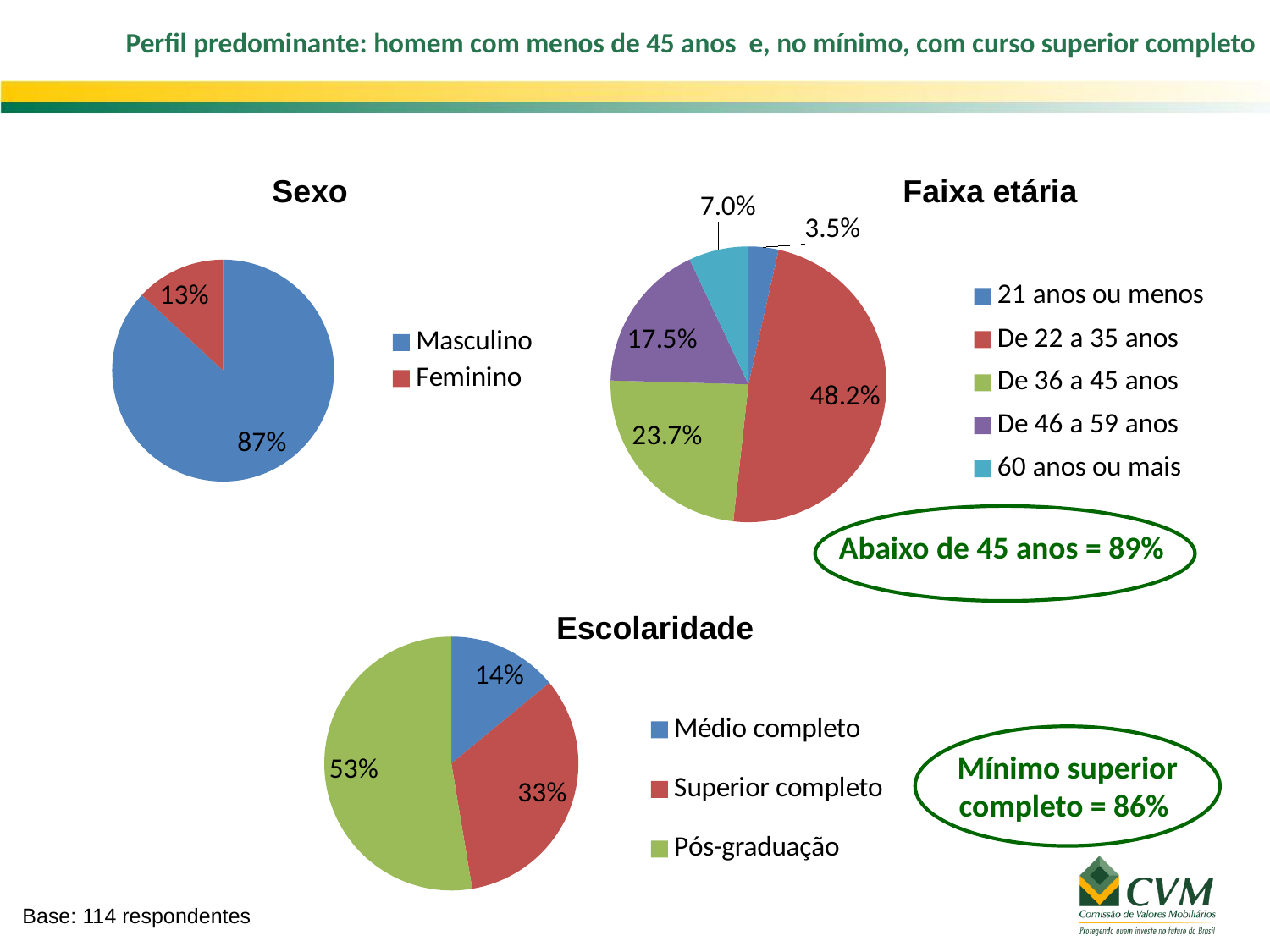
In the 'Faixa etária' chart, how many age groups does the legend list? 5 In the 'Faixa etária' chart, what percentage is '60 anos ou mais'? 7.0% In the 'Faixa etária' chart, which is larger: 'De 36 a 45 anos' or 'De 46 a 59 anos'? De 36 a 45 anos In the 'Faixa etária' chart, which age group has the largest share? De 22 a 35 anos In the 'Escolaridade' chart, what is the difference between Superior completo and Médio completo? 19% In the 'Faixa etária' chart, which age group has the smallest share? 21 anos ou menos In the 'Sexo' chart, what is the difference between the Masculino and Feminino shares? 74% What type of chart is the 'Escolaridade' chart? Pie chart In the 'Sexo' chart, what percentage is Feminino? 13% In the 'Escolaridade' chart, what percentage is Pós-graduação? 53% In the 'Sexo' chart, what percentage is Masculino? 87% In the 'Faixa etária' chart, what percentage is 'De 22 a 35 anos'? 48.2%